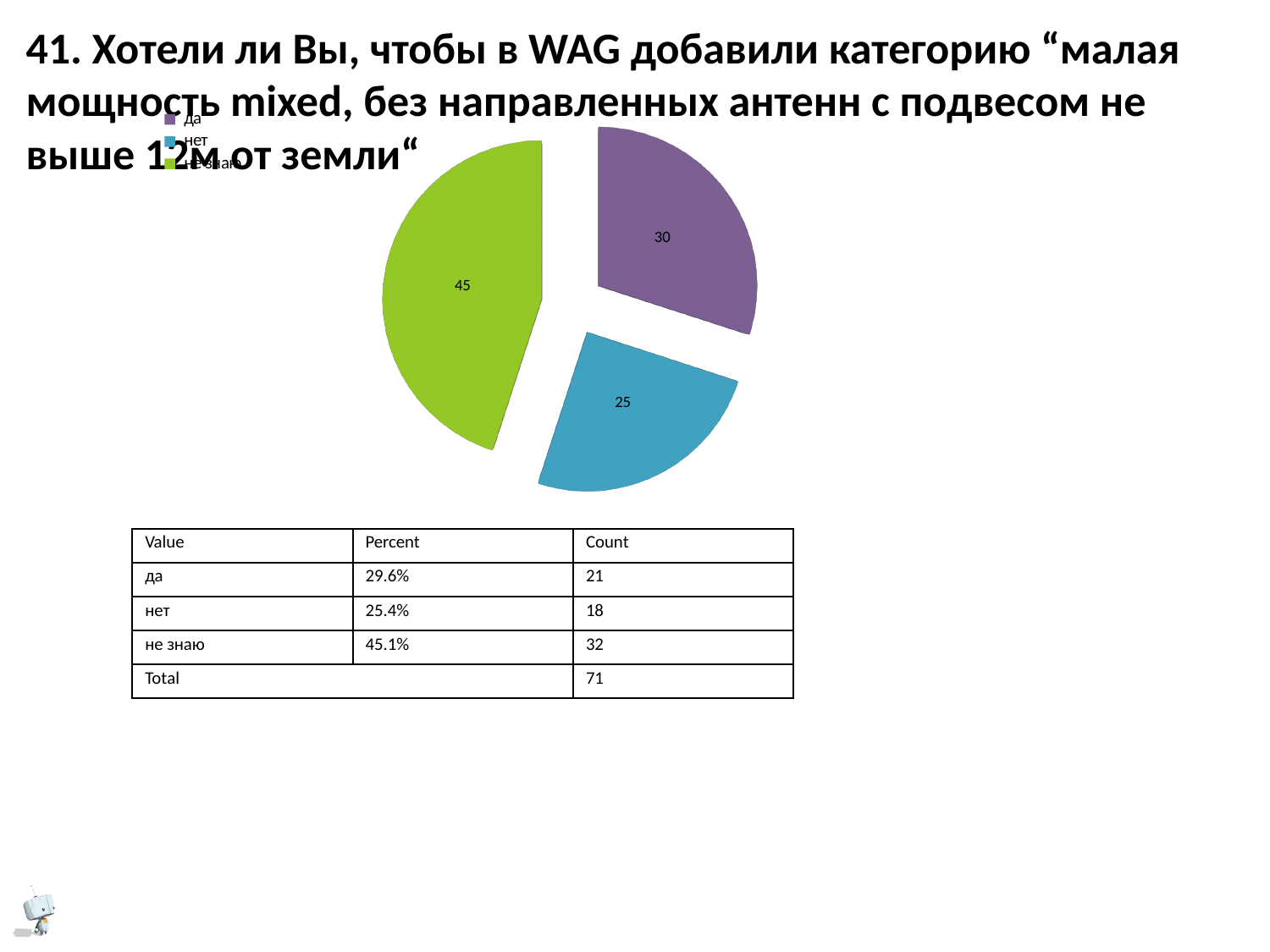
Which is larger in the pie chart, the purple slice or the blue slice? the purple slice What colour is the slice labelled 45 in the pie chart? green What value is printed on the blue slice of the pie chart? 25 What value is printed on the purple slice of the pie chart? 30 What value is printed on the green slice of the pie chart? 45 What is the first entry listed in the pie chart's legend? да Which slice of the pie chart has the largest value? the green slice (45) What kind of chart is shown on the slide? pie chart How many entries does the pie chart's legend list? 3 How many slices does the pie chart have? 3 What is the difference between the values on the green slice and the purple slice of the pie chart? 15 Which slice of the pie chart has the smallest value? the blue slice (25)